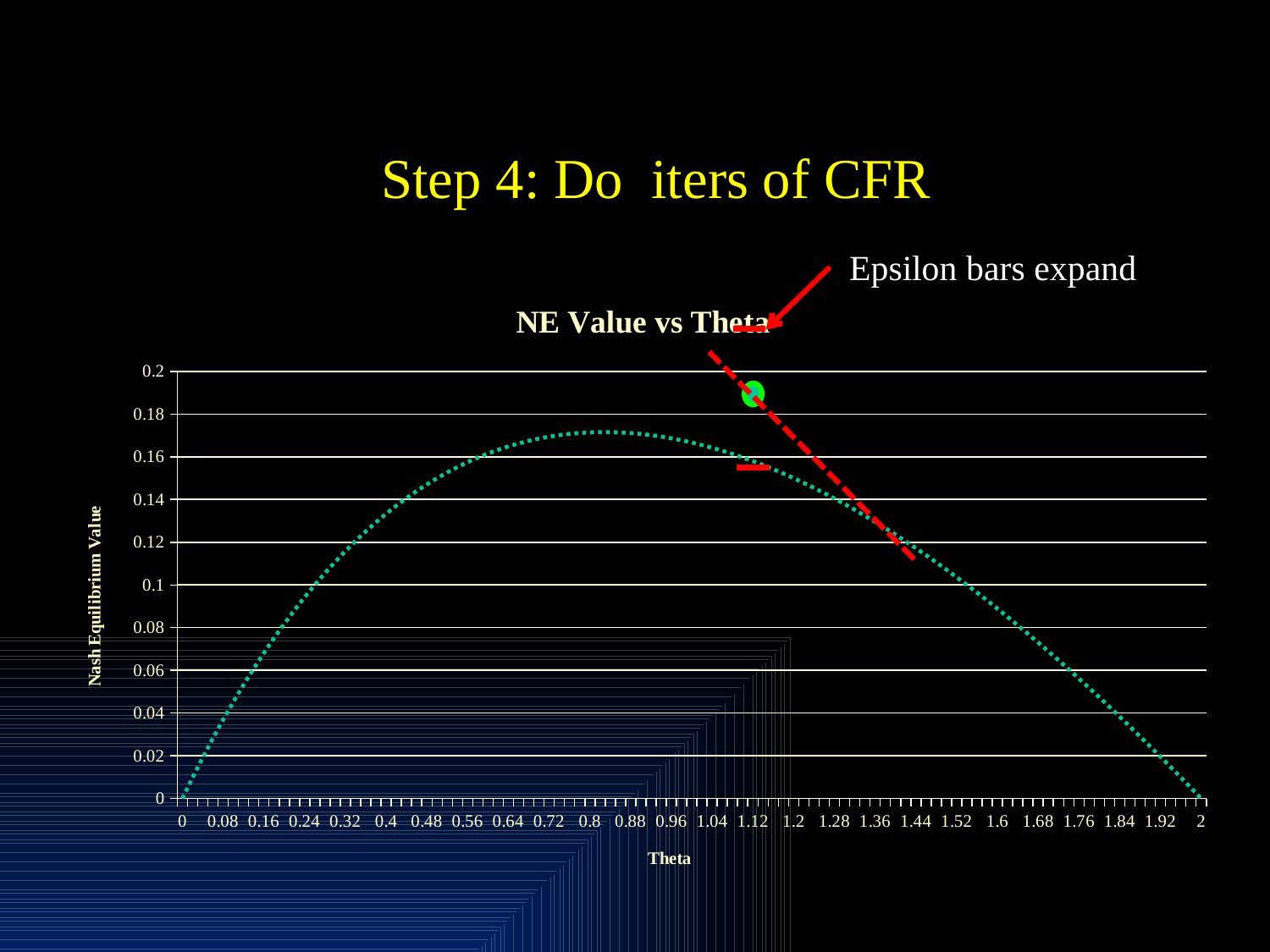
What is the label of the vertical axis of the chart? Nash Equilibrium Value Is the Nash Equilibrium Value at Theta = 0.56 greater or less than 0.14? greater What is the title of the chart? NE Value vs Theta What is the Nash Equilibrium Value at Theta = 0? 0 Which has the larger Nash Equilibrium Value, Theta = 0.32 or Theta = 1.76? Theta = 0.32 Is the Nash Equilibrium Value at Theta = 1.92 greater or less than 0.04? less Does the Nash Equilibrium Value rise or fall as Theta increases from 1.2 to 2? fall What is the Nash Equilibrium Value at Theta = 2? 0 What kind of chart is shown on the slide? line chart Is the Nash Equilibrium Value at Theta = 1.76 greater or less than 0.08? less Does the Nash Equilibrium Value rise or fall as Theta increases from 0 to 0.8? rise